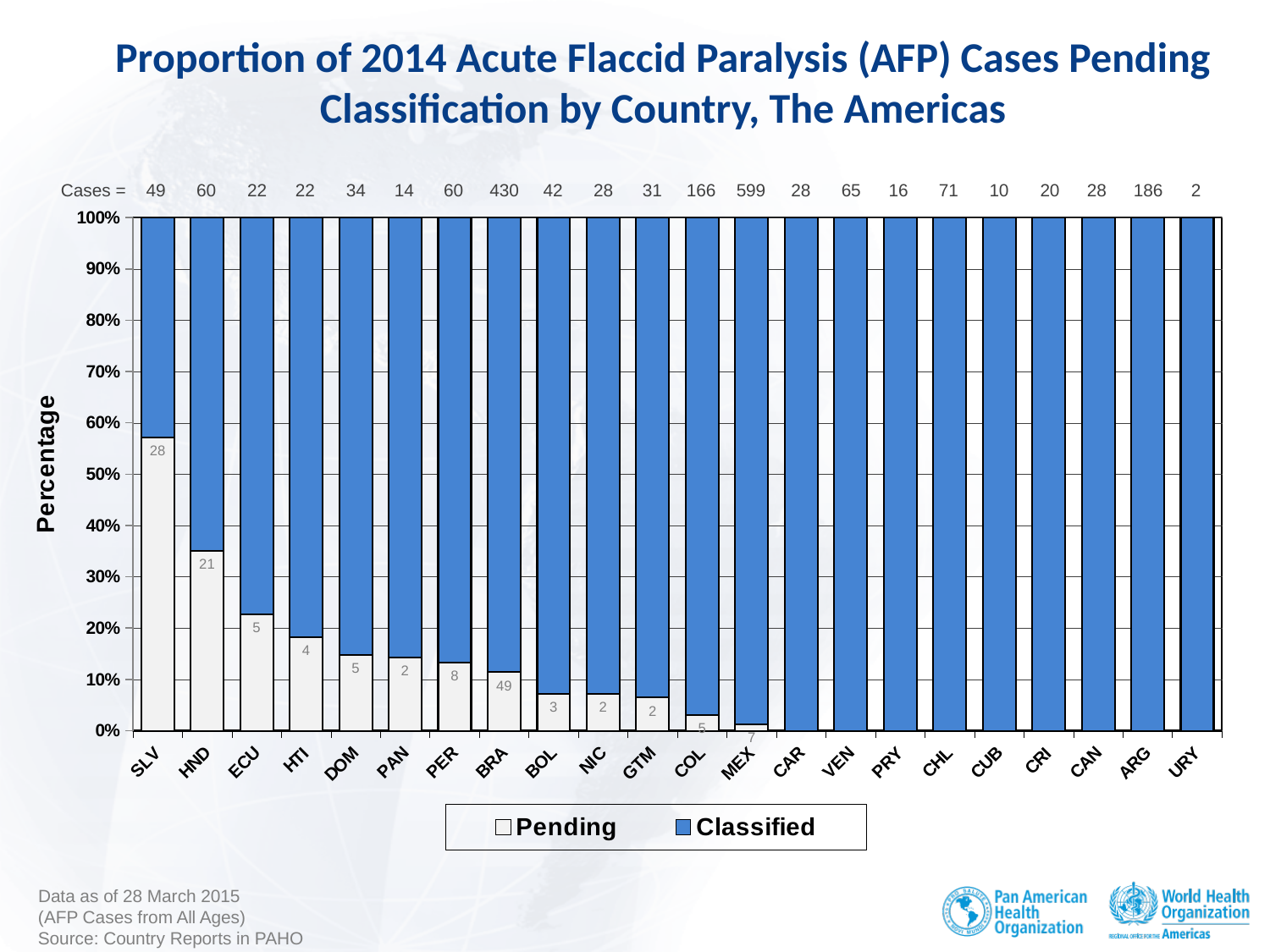
Which country has the highest proportion of pending cases? SLV Is the pending proportion for SLV greater or less than 50%? greater Does the proportion of pending cases rise or fall moving from SLV to MEX along the x axis? fall What type of chart is shown on the slide? stacked bar chart What is the total number of cases shown for URY in the 'Cases =' row? 2 How many countries are shown along the x axis? 22 Is the pending proportion for HND greater or less than 40%? less What is the total number of cases shown for MEX in the 'Cases =' row? 599 How many pending AFP cases are labelled for BRA? 49 What are the two series named in the legend? Pending and Classified How many series does the legend list? 2 How many pending AFP cases are labelled for SLV? 28